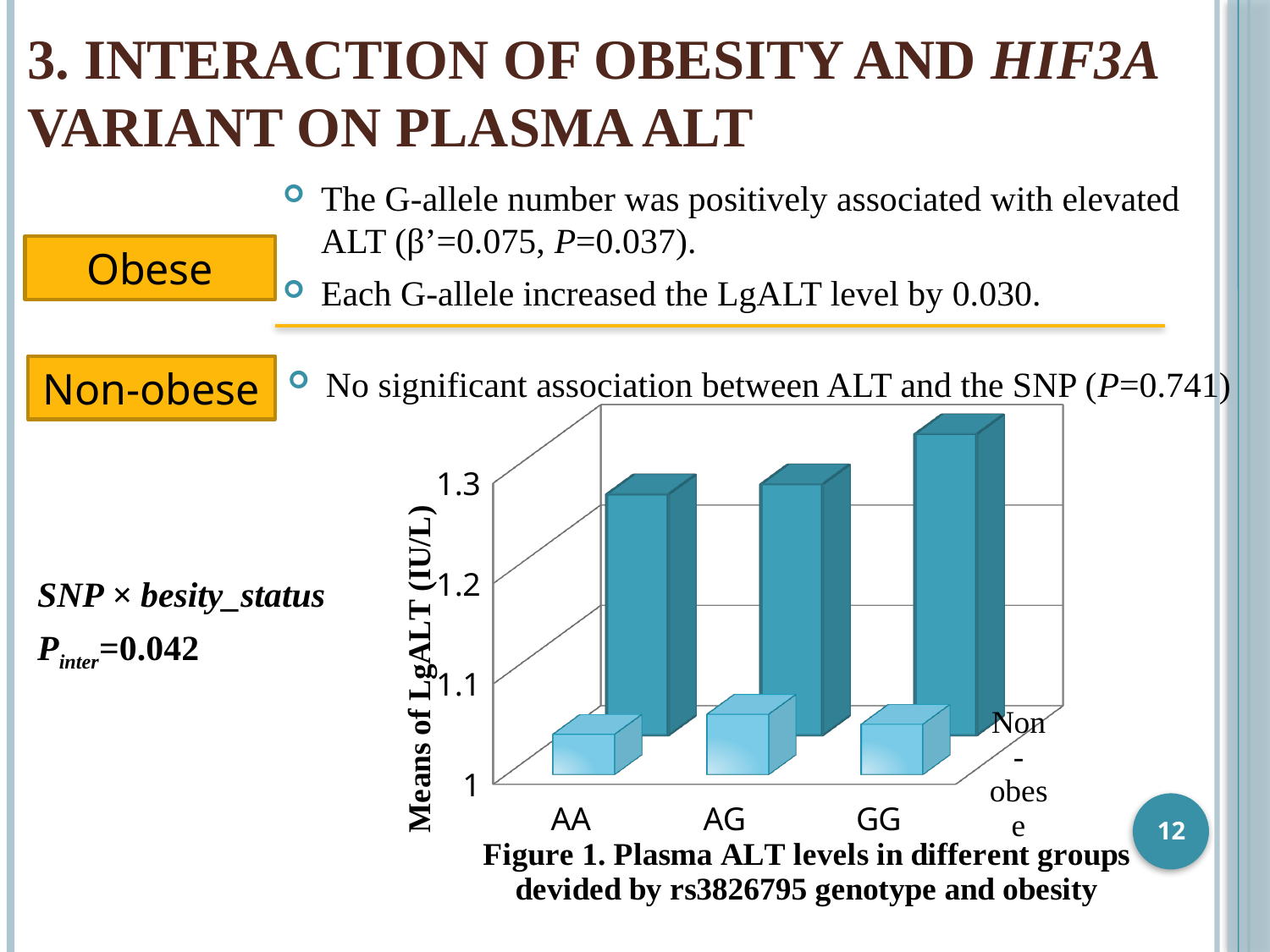
Do the dark teal bars rise or fall from AA to GG along the x axis? rise How many rows (groups) of bars are plotted in the chart? 2 Is the value of the dark teal bar for AA greater or less than 1.2? greater What kind of chart is shown in Figure 1? bar chart What is the lowest tick value shown on the vertical axis of the chart? 1 How many genotype categories are shown on the x axis of the chart? 3 Which genotype has the tallest bar in the back (dark teal) row of the chart? GG For genotype GG, which bar is taller: the dark teal bar or the light blue Non-obese bar? the dark teal bar Is the value of the light blue (Non-obese) bar for GG greater or less than 1.2? less What is the title of the vertical axis of the chart? Means of LgALT (IU/L) Is the value of the light blue (Non-obese) bar for AA greater or less than 1.1? less